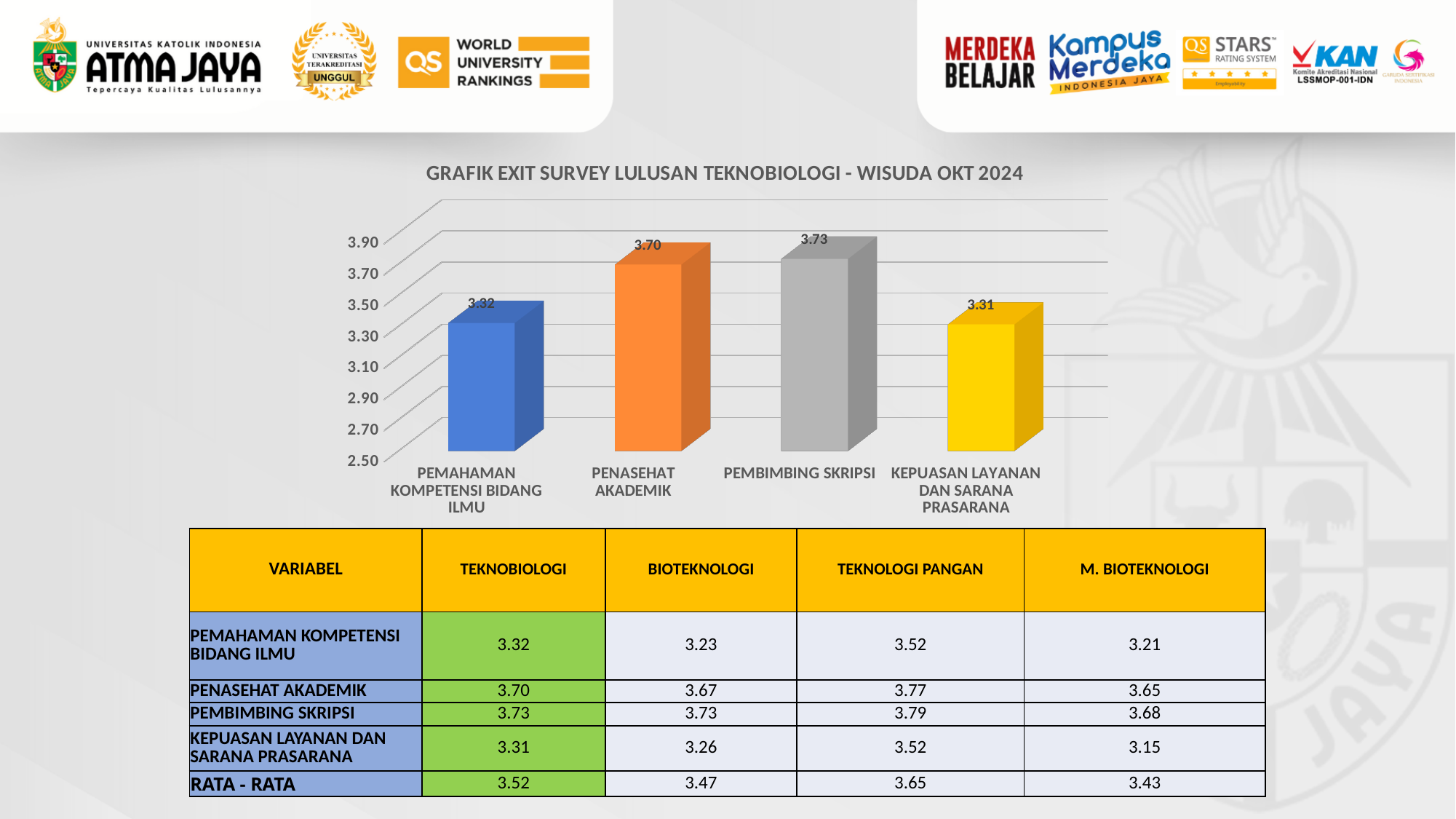
What kind of chart is shown on the slide? bar chart What is the title of the chart? GRAFIK EXIT SURVEY LULUSAN TEKNOBIOLOGI - WISUDA OKT 2024 Which category has the highest value in the chart? PEMBIMBING SKRIPSI Which category has the lowest value in the chart? KEPUASAN LAYANAN DAN SARANA PRASARANA What is the value for KEPUASAN LAYANAN DAN SARANA PRASARANA in the chart? 3.31 What is the value for PENASEHAT AKADEMIK in the chart? 3.70 Which is larger in the chart: the value for PENASEHAT AKADEMIK or the value for KEPUASAN LAYANAN DAN SARANA PRASARANA? PENASEHAT AKADEMIK Is the value for PEMAHAMAN KOMPETENSI BIDANG ILMU greater or less than 3.50? less How many categories are shown in the chart? 4 What is the value for PEMBIMBING SKRIPSI in the chart? 3.73 What is the value for PEMAHAMAN KOMPETENSI BIDANG ILMU in the chart? 3.32 What is the difference between the values for PEMBIMBING SKRIPSI and PEMAHAMAN KOMPETENSI BIDANG ILMU? 0.41